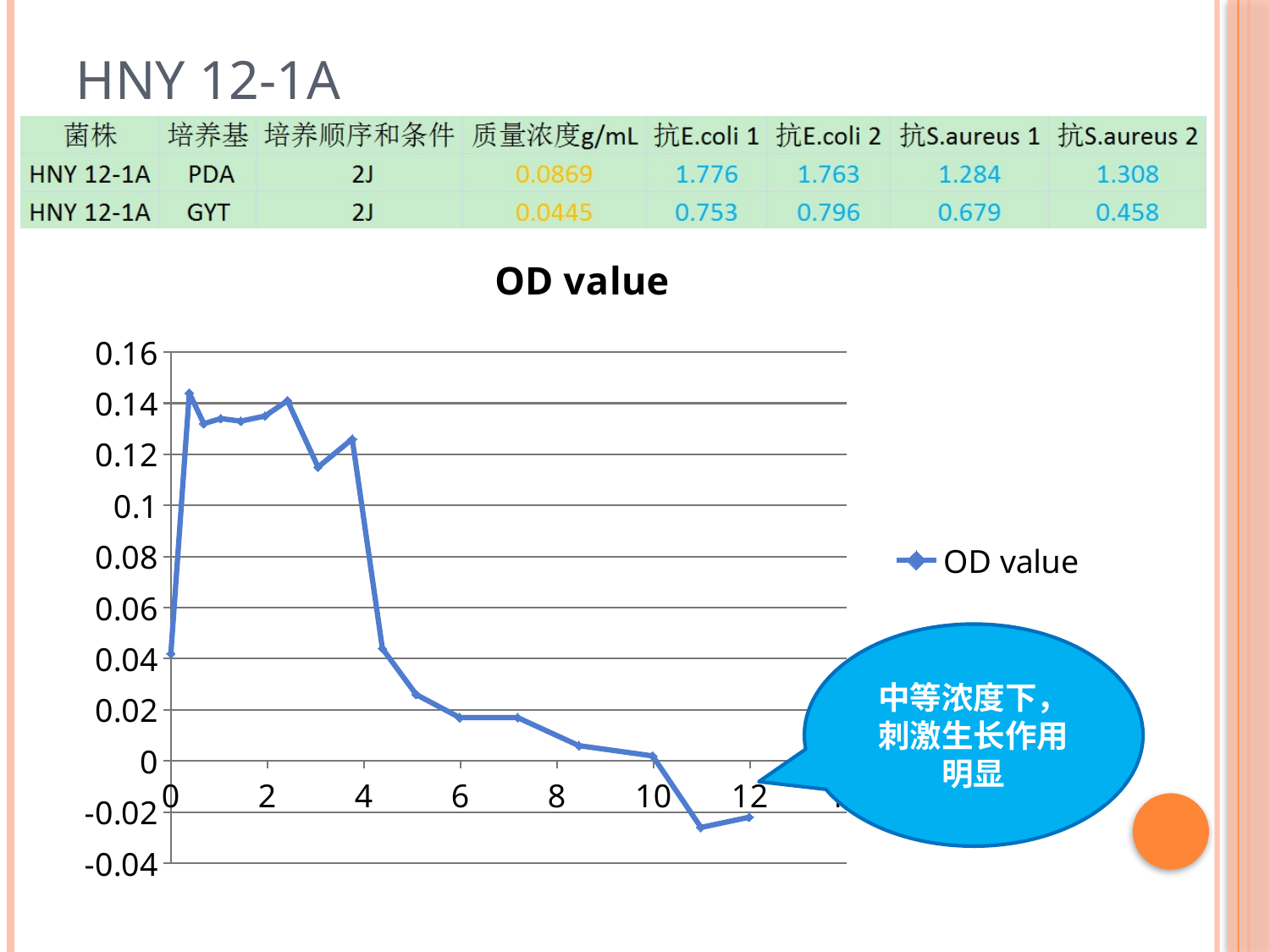
Is the OD value at x = 12 greater or less than 0? less What is the highest value shown on the chart's vertical axis? 0.16 Which is larger, the OD value at x = 6 or the OD value at x = 10? x = 6 Is the highest OD value on the chart greater or less than 0.12? greater Do the OD values rise or fall along the x axis between x = 4 and x = 10? fall How many series does the chart legend list? 1 What is the title of the chart? OD value What kind of chart is shown on the slide? line chart Is the OD value at x = 2 greater or less than 0.12? greater Which is larger, the OD value at x = 2 or the OD value at x = 8? x = 2